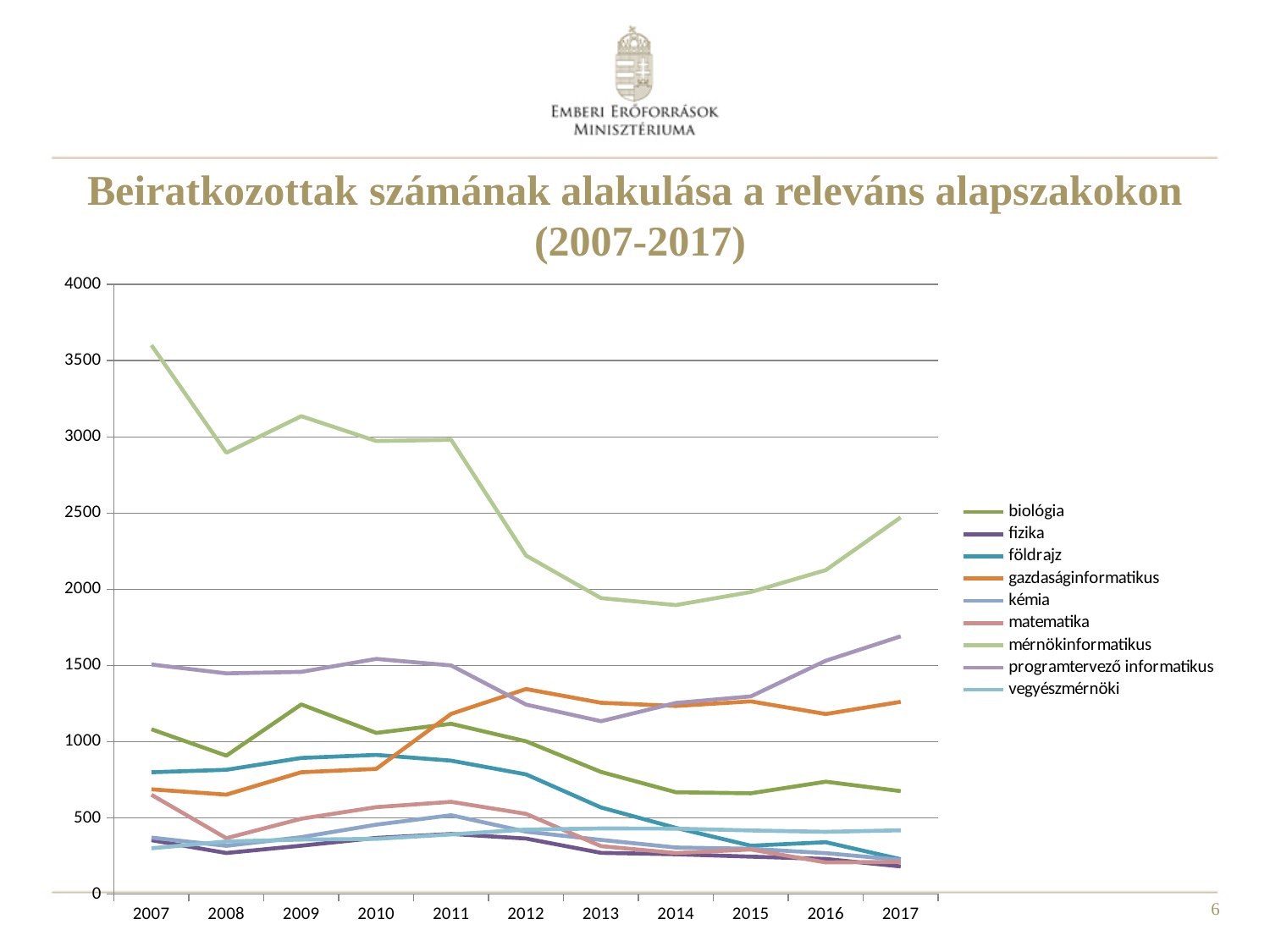
Is the value for mérnökinformatikus in 2014 greater or less than 2000? less Is the value for biológia in 2009 greater or less than 1000? greater How many years are shown along the x axis? 11 Is the value for földrajz in 2017 greater or less than 500? less Does the programtervező informatikus line rise or fall from 2013 to 2017? rise What is the title of the chart? Beiratkozottak számának alakulása a releváns alapszakokon (2007-2017) How many series does the legend list? 9 What kind of chart is shown on the slide? line chart Which is larger in 2017, programtervező informatikus or gazdaságinformatikus? programtervező informatikus Does the mérnökinformatikus line rise or fall from 2007 to 2014? fall Which series has the highest value in 2007? mérnökinformatikus